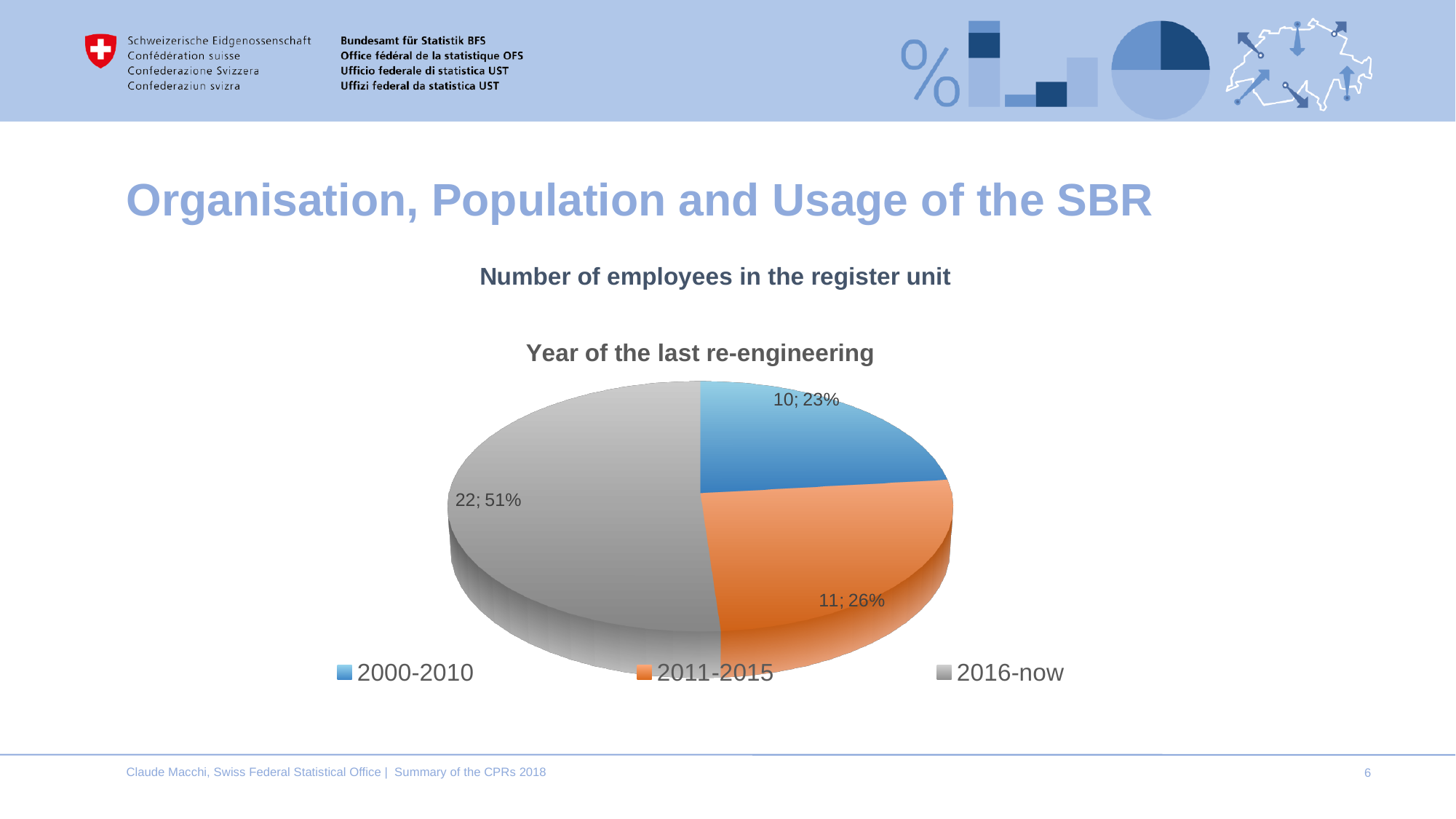
What share of the pie does the 2016-now slice represent in the "Year of the last re-engineering" chart? 51% What is the count shown for the 2011-2015 slice in the "Year of the last re-engineering" chart? 11 What is the count shown for the 2000-2010 slice in the "Year of the last re-engineering" chart? 10 How many slices does the "Year of the last re-engineering" pie chart have? 3 What colour is the 2011-2015 slice in the "Year of the last re-engineering" chart? Orange What share of the pie does the 2000-2010 slice represent in the "Year of the last re-engineering" chart? 23% How many entries does the legend of the "Year of the last re-engineering" chart list? 3 Which category has the largest slice in the "Year of the last re-engineering" chart? 2016-now What kind of chart is shown under the title "Year of the last re-engineering"? Pie chart In the "Year of the last re-engineering" chart, what is the difference between the counts for 2016-now and 2011-2015? 11 What is the count shown for the 2016-now slice in the "Year of the last re-engineering" chart? 22 Which category has the smallest slice in the "Year of the last re-engineering" chart? 2000-2010